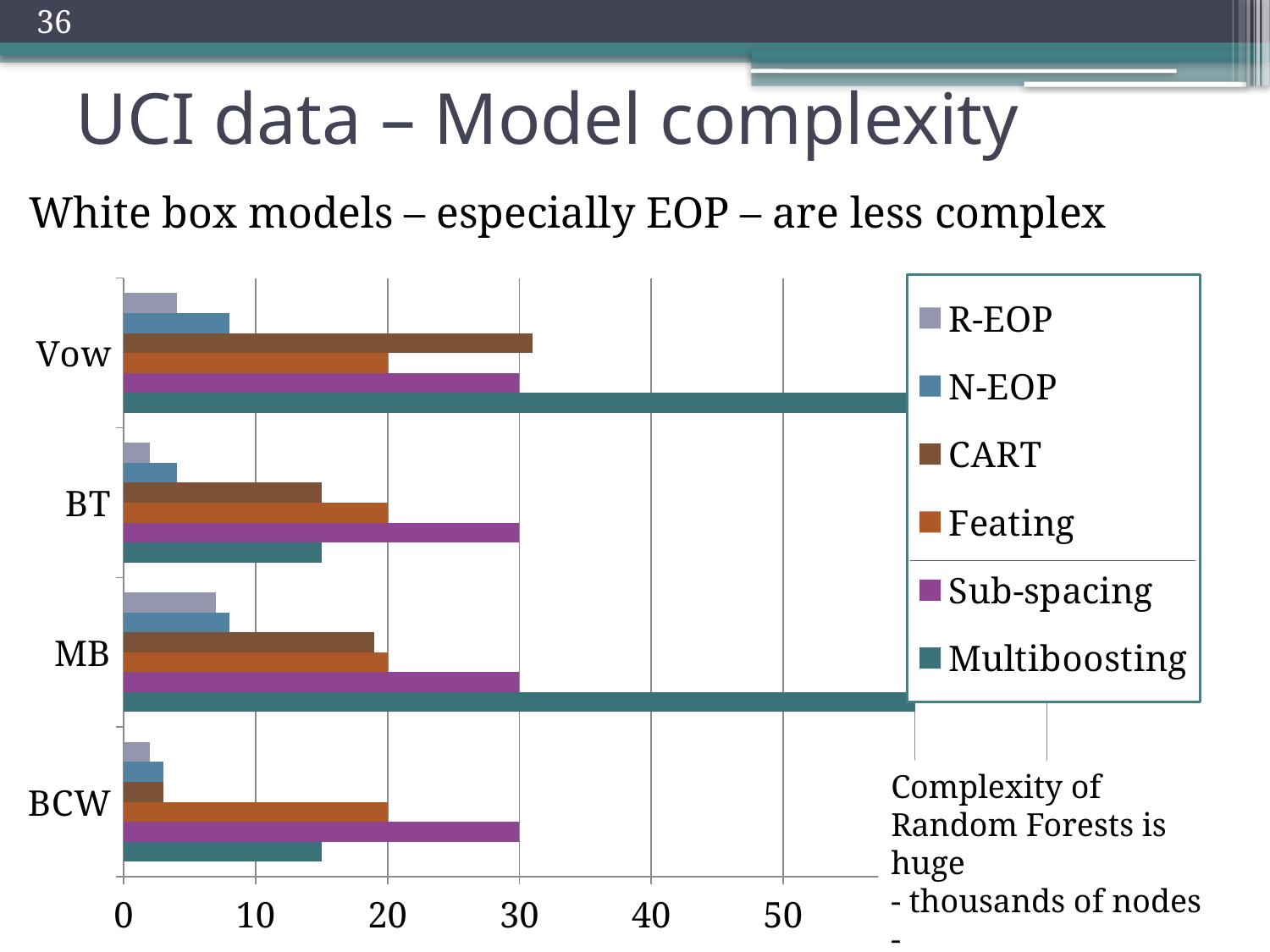
Is the Multiboosting value for Vow greater or less than 50? greater What kind of chart is shown on the slide? bar chart Is the R-EOP value for Vow greater or less than 10? less Which series has the highest value for BT? Sub-spacing Which series is listed last in the chart's legend? Multiboosting Which series has the lowest value for Vow? R-EOP Is the Multiboosting value for BT greater or less than 20? less How many series does the chart's legend list? 6 For Vow, which is larger: the CART value or the Feating value? CART How many categories are shown on the vertical axis of the chart? 4